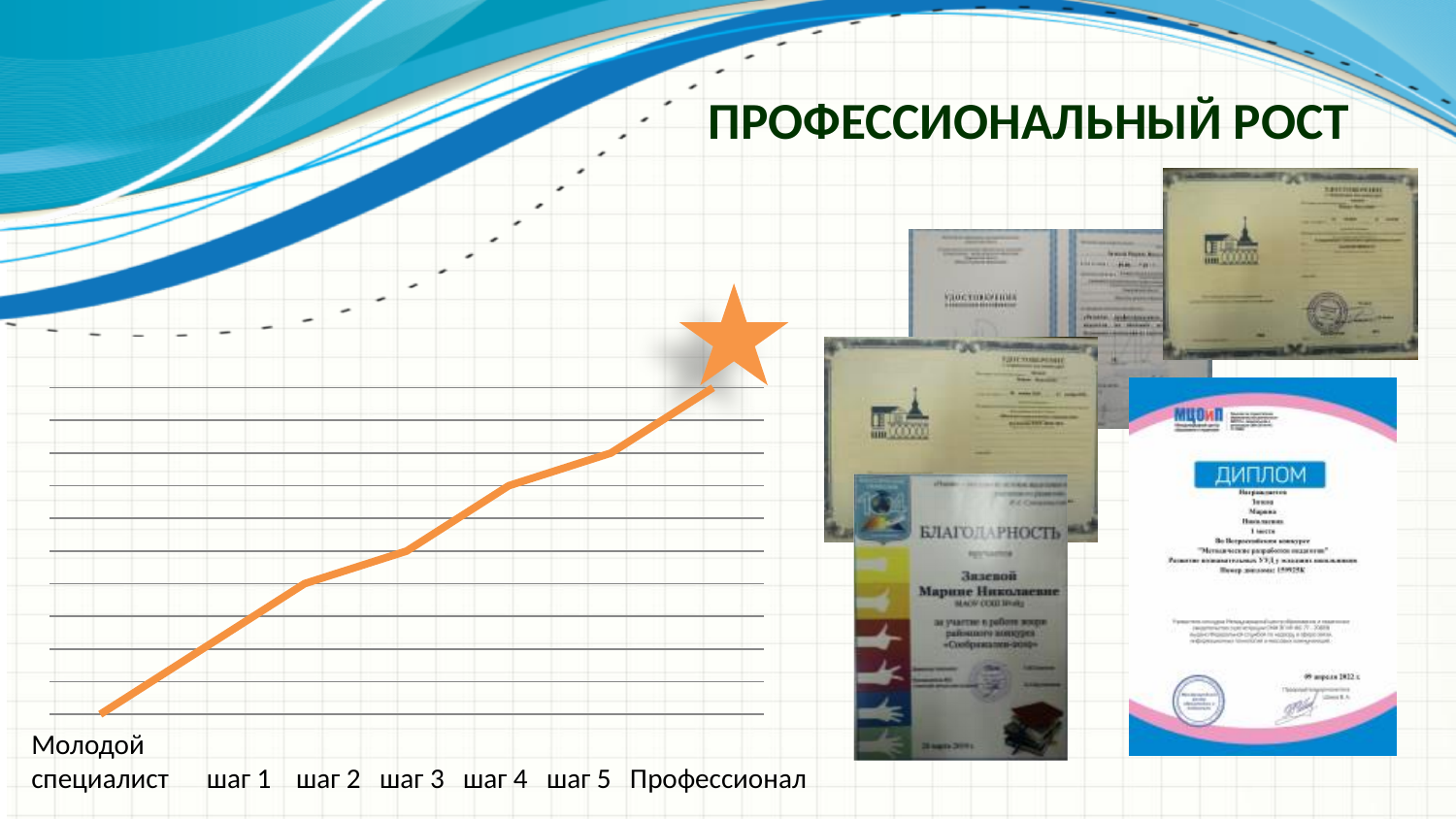
What is the label of the first category on the x axis? Молодой специалист What kind of chart is shown on the slide? line chart Do the values rise or fall along the x axis from "Молодой специалист" to "Профессионал"? rise What colour is the line plotted on the chart? orange Which is higher on the line, the point for "шаг 1" or the point for "шаг 5"? шаг 5 Which category has the highest point on the line? Профессионал Which is higher on the line, the point for "Молодой специалист" or the point for "шаг 3"? шаг 3 Which category has the lowest point on the line? Молодой специалист How many categories are labelled along the x axis of the chart? 7